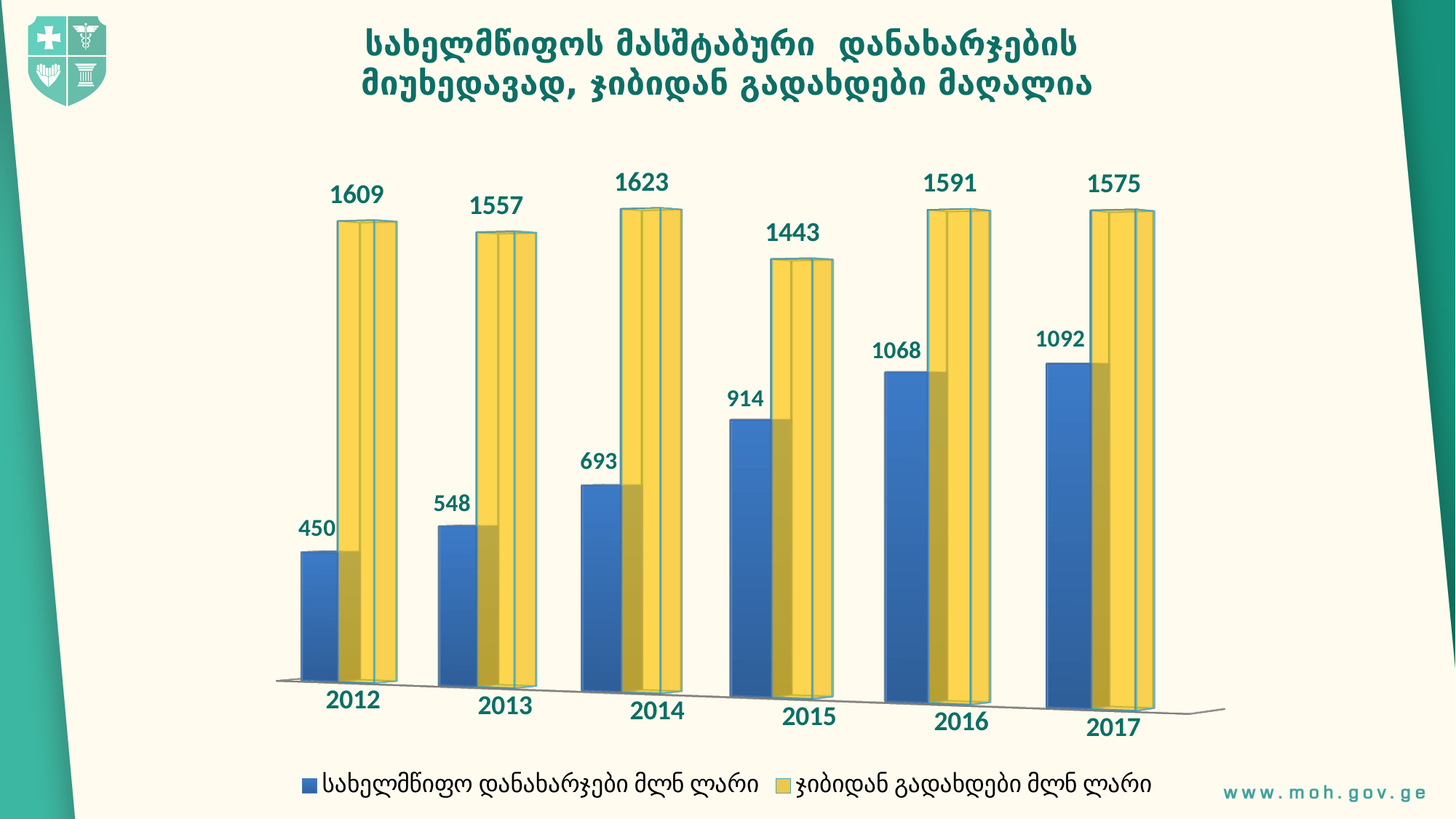
What is the value of the yellow series (ჯიბიდან გადახდები მლნ ლარი) for 2015? 1443 Which is larger in 2013: the blue series value or the yellow series value? the yellow series (1557) Which colour represents ჯიბიდან გადახდები მლნ ლარი in the legend? yellow What kind of chart is shown on the slide? bar chart What is the value of the blue series (სახელმწიფო დანახარჯები მლნ ლარი) for 2012? 450 In which year is the yellow series (ჯიბიდან გადახდები მლნ ლარი) highest? 2014 How many years are shown on the x axis? 6 Does the blue series (სახელმწიფო დანახარჯები მლნ ლარი) rise or fall from 2012 to 2017? rise What is the difference between the yellow and blue values in 2016? 523 What is the value of the blue series (სახელმწიფო დანახარჯები მლნ ლარი) for 2017? 1092 How many series does the legend list? 2 In which year is the blue series (სახელმწიფო დანახარჯები მლნ ლარი) lowest? 2012